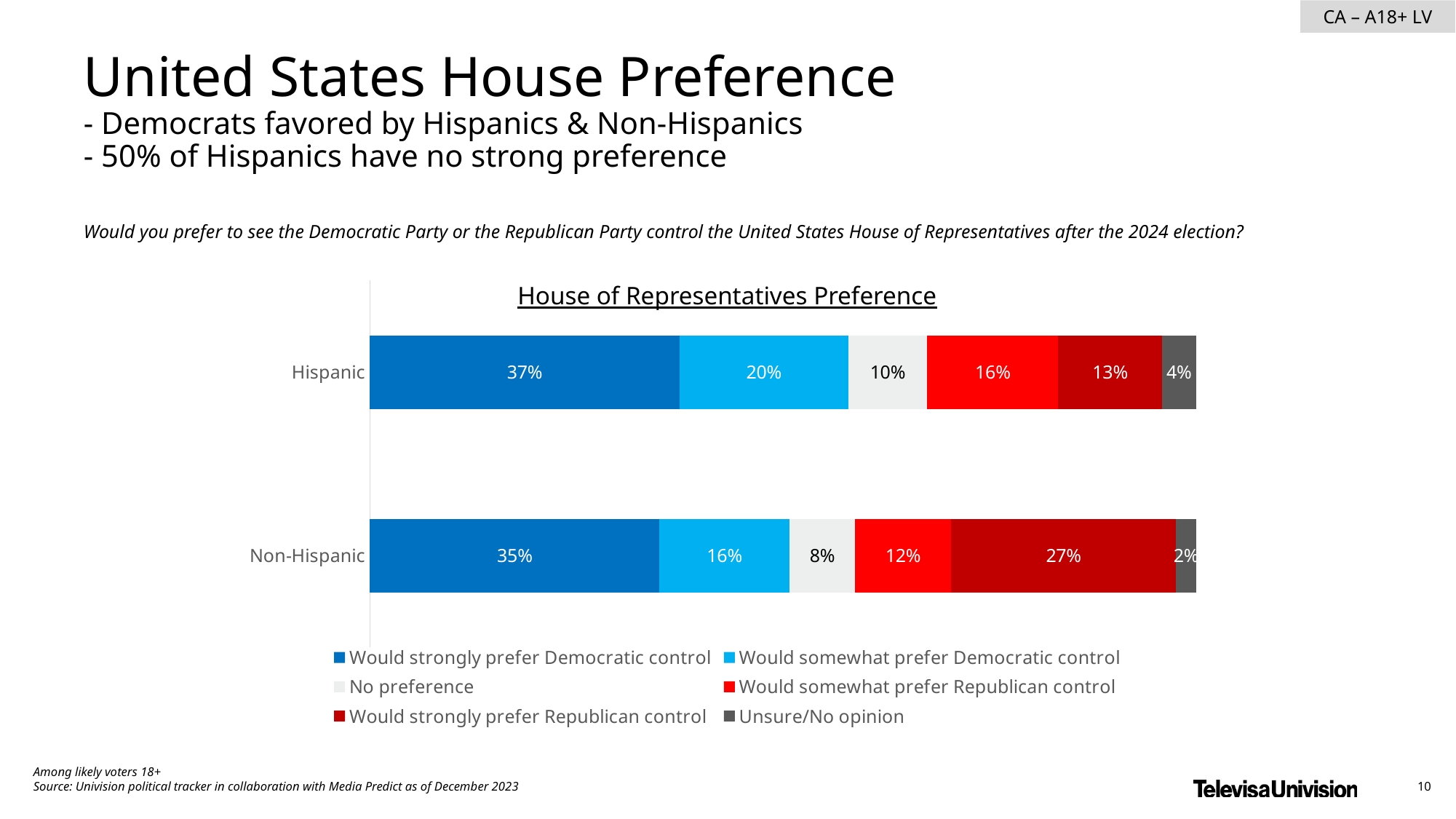
What is the 'Unsure/No opinion' value for Hispanic voters? 4% What is the 'No preference' value for Non-Hispanic voters? 8% Which response category has the highest value in the Hispanic bar? Would strongly prefer Democratic control Which group has a larger share that would somewhat prefer Democratic control, Hispanic or Non-Hispanic? Hispanic What is the difference between the 'Would strongly prefer Republican control' values for Non-Hispanic and Hispanic voters? 14 percentage points Which response category has the lowest value in the Non-Hispanic bar? Unsure/No opinion What percentage of Non-Hispanic likely voters would strongly prefer Republican control of the House? 27% What kind of chart is shown on the slide? Stacked bar chart What percentage of Hispanic likely voters would strongly prefer Democratic control of the House? 37% How many series does the legend list? 6 How many groups (bars) are shown in the chart? 2 What is the title of the chart? House of Representatives Preference